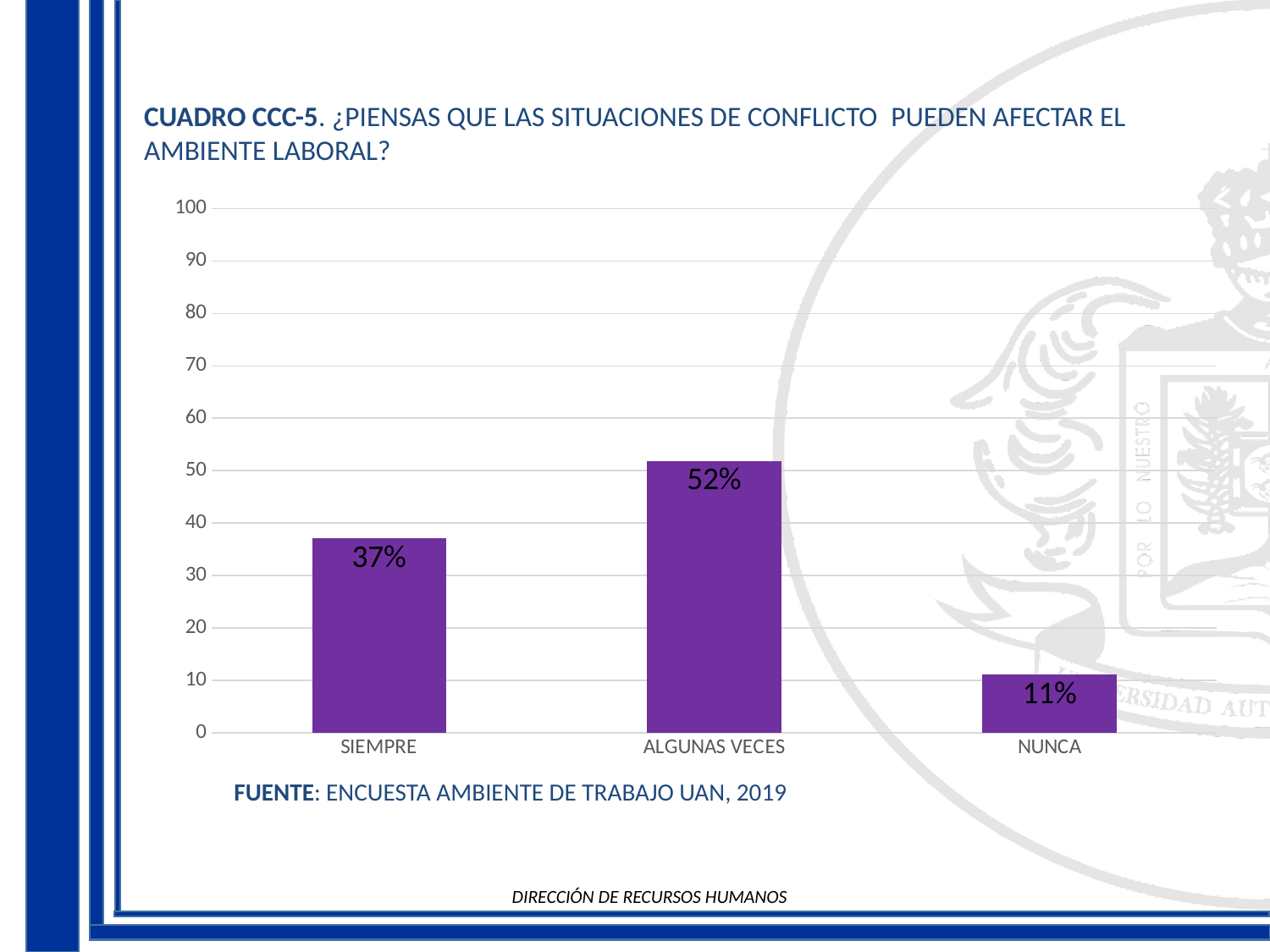
Which category has the lowest value? NUNCA Which is larger, the value for SIEMPRE or the value for NUNCA? SIEMPRE How many categories are shown on the x axis? 3 What is the value for NUNCA? 11% Is the value for ALGUNAS VECES greater or less than 50? greater What is the value for ALGUNAS VECES? 52% Which category has the highest value? ALGUNAS VECES What is the difference between the values for SIEMPRE and NUNCA? 26% What kind of chart is shown on the slide? bar chart What is the difference between the values for ALGUNAS VECES and SIEMPRE? 15% What source is cited below the chart? ENCUESTA AMBIENTE DE TRABAJO UAN, 2019 What is the value for SIEMPRE? 37%